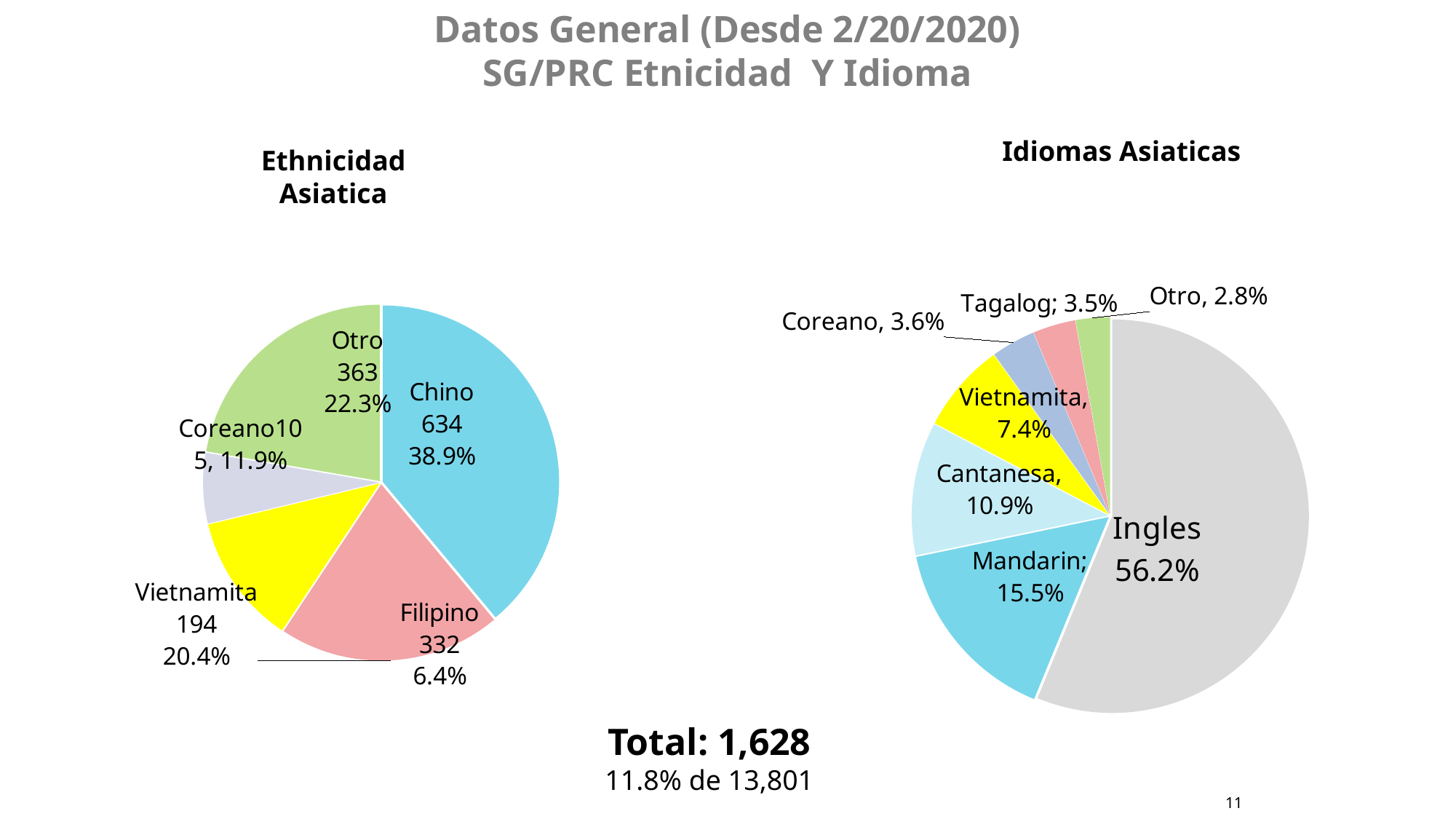
In the Idiomas Asiaticas chart, which is larger, Cantanesa or Vietnamita? Cantanesa In the Ethnicidad Asiatica chart, what is the difference between the Chino and Filipino values? 302 In the Ethnicidad Asiatica chart, what percentage is shown for Otro? 22.3% In the Idiomas Asiaticas chart, which language has the smallest slice? Otro In the Ethnicidad Asiatica chart, which is larger, Otro or Vietnamita? Otro In the Ethnicidad Asiatica chart, what is the value for Chino? 634 In the Idiomas Asiaticas chart, what share is shown for Ingles? 56.2% In the Ethnicidad Asiatica chart, which category has the largest slice? Chino In the Ethnicidad Asiatica chart, what is the value for Vietnamita? 194 In the Idiomas Asiaticas chart, what percentage is shown for Mandarin? 15.5% How many slices does the Ethnicidad Asiatica chart have? 5 What type of chart is the Idiomas Asiaticas chart? Pie chart